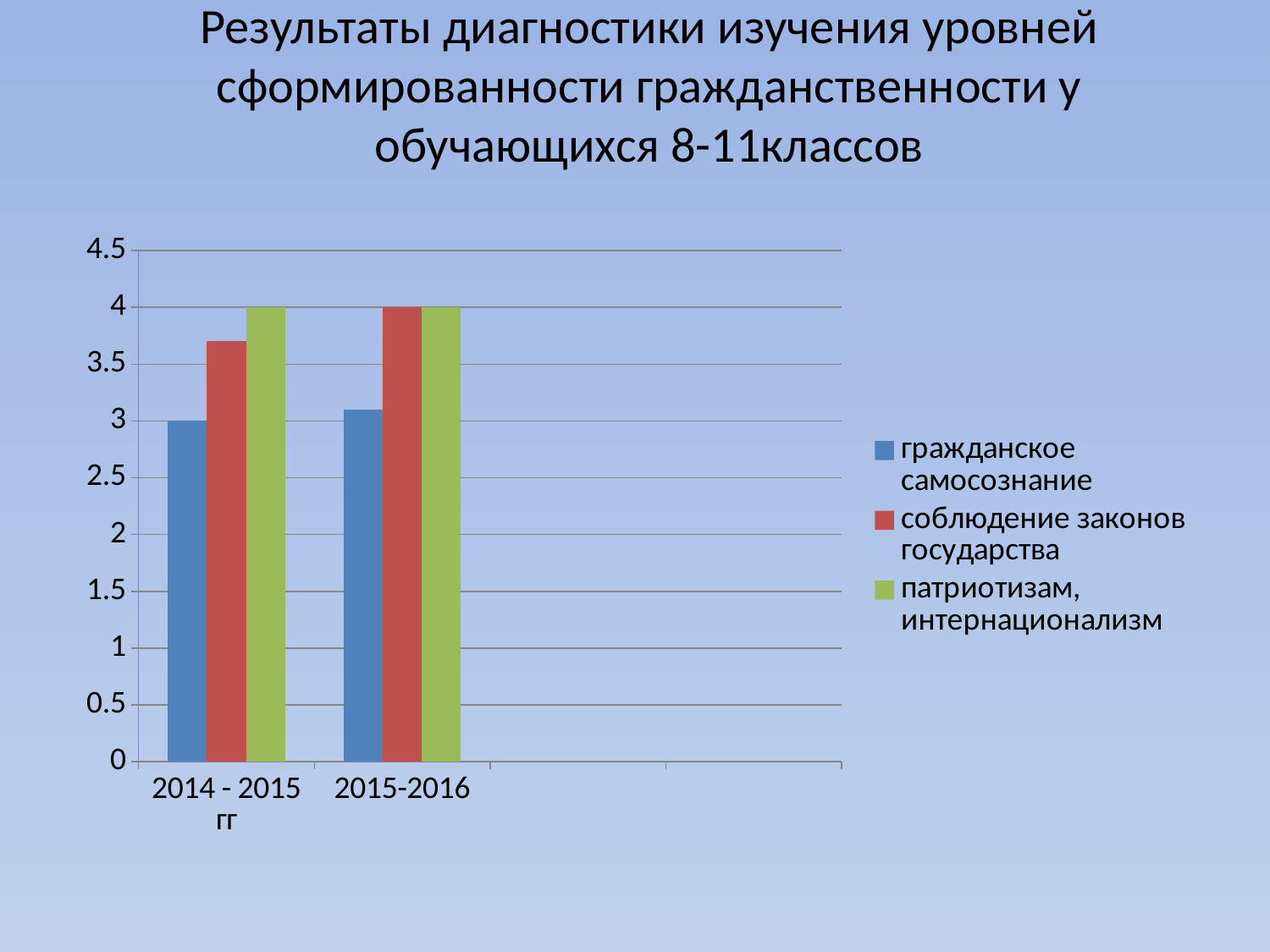
What kind of chart is shown on the slide? bar chart Which series has the lowest value in 2014 - 2015 гг? гражданское самосознание Does the value for соблюдение законов государства rise or fall from 2014 - 2015 гг to 2015-2016? rise What is the value for патриотизам, интернационализм in 2014 - 2015 гг? 4 What is the value for гражданское самосознание in 2014 - 2015 гг? 3 Is the value for соблюдение законов государства in 2014 - 2015 гг greater or less than 3.5? greater Is the value for гражданское самосознание in 2015-2016 greater or less than 3.5? less Which series has the lowest value in 2015-2016? гражданское самосознание How many series does the legend list? 3 What is the value for соблюдение законов государства in 2015-2016? 4 What is the difference between патриотизам, интернационализм and гражданское самосознание in 2014 - 2015 гг? 1 How many categories are shown on the x axis? 2